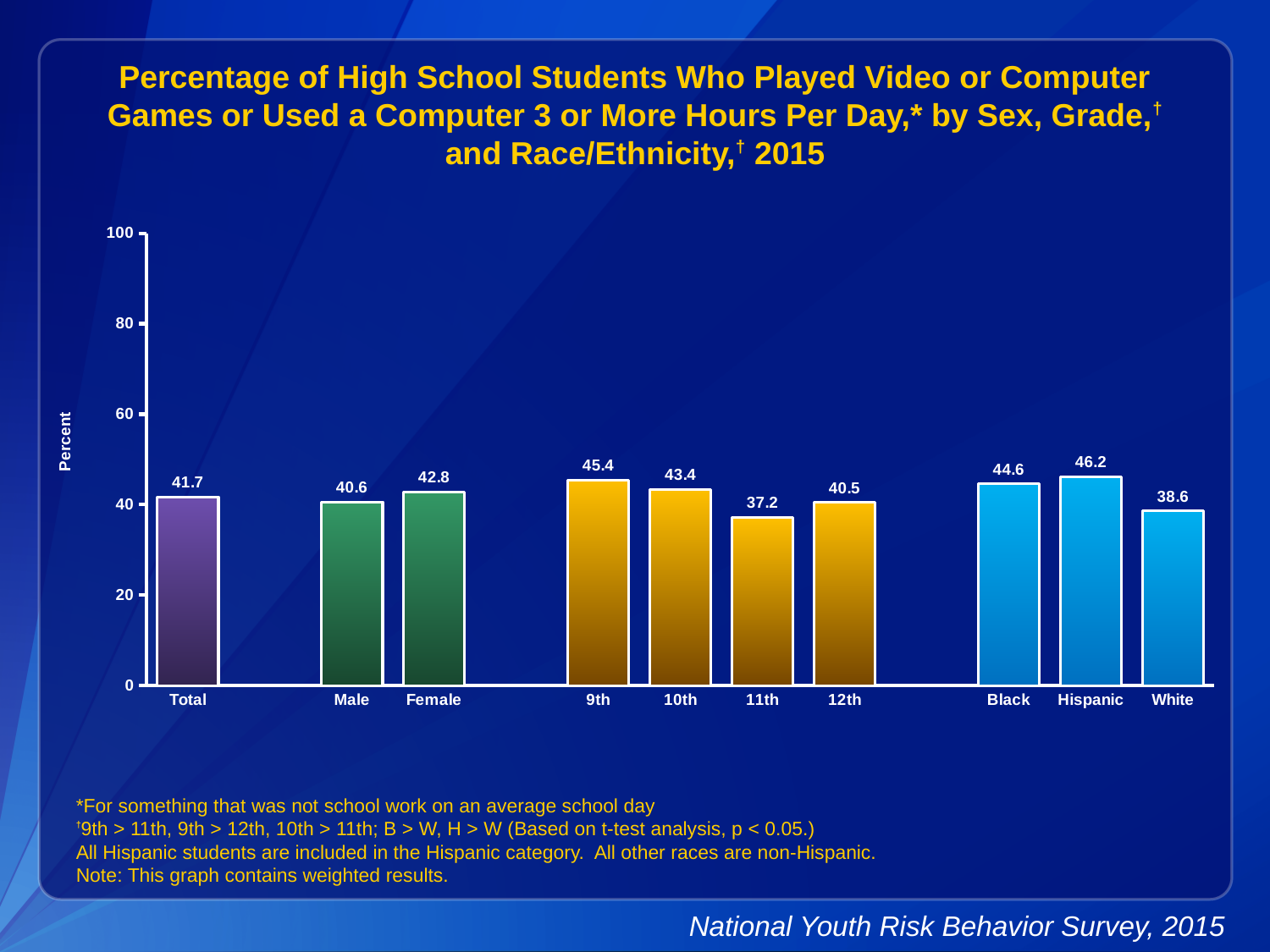
What is the difference between the values for Female and Male? 2.2 What is the value for 11th grade? 37.2 How many categories are shown on the x axis? 10 Which category has the lowest value? 11th Which category has the highest value? Hispanic Is the value for 10th grade greater or less than 40? greater What is the value for Total? 41.7 Which is larger, the value for Black or the value for White? Black What is the difference between the values for 9th grade and 12th grade? 4.9 What is the value for Hispanic students? 46.2 What is the value for Female? 42.8 What kind of chart is this? Bar chart